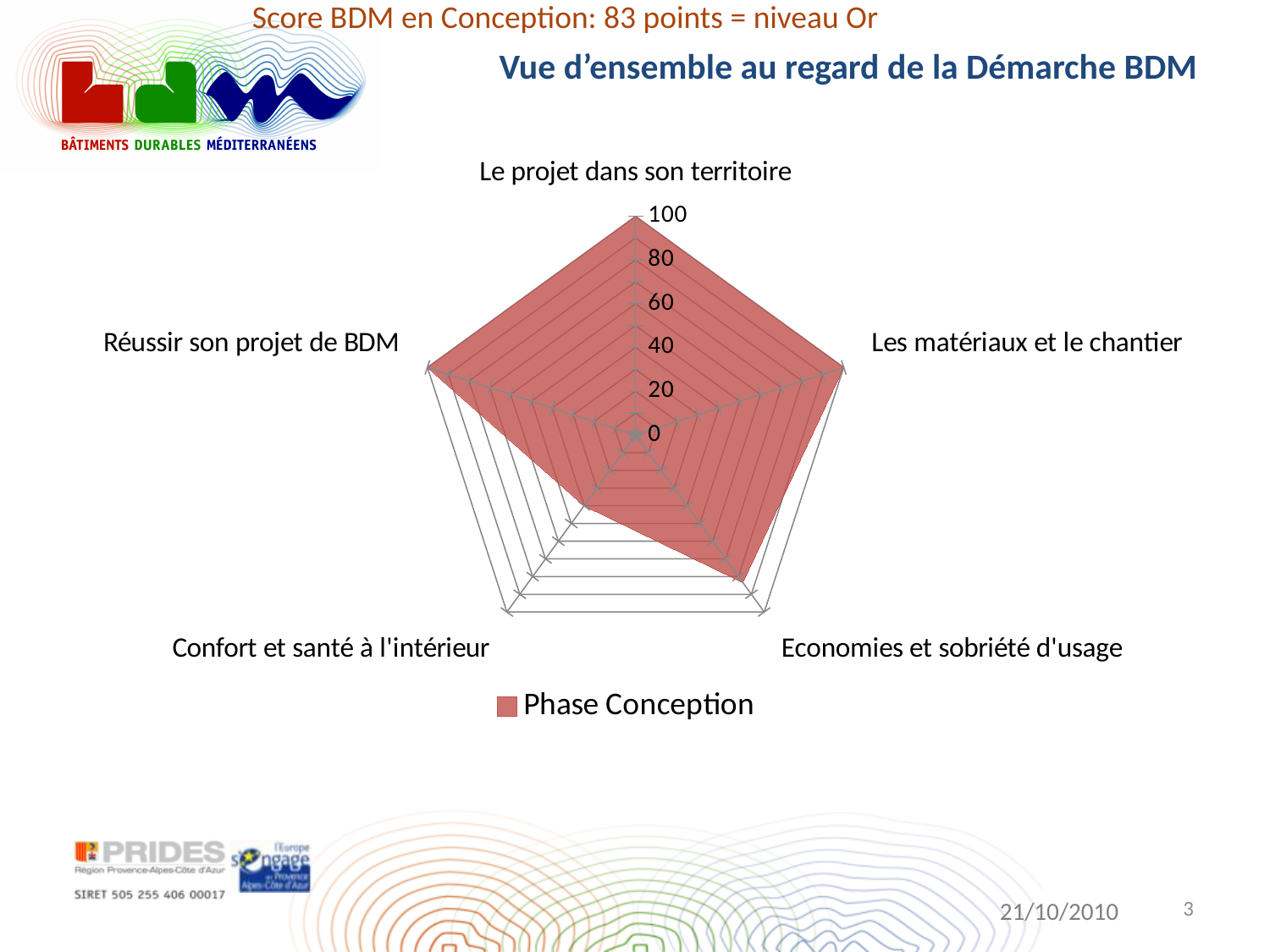
Is the value for Confort et santé à l'intérieur greater or less than 60? less Is the value for Confort et santé à l'intérieur greater or less than 20? greater What is the name of the series shown in the legend? Phase Conception How many series does the legend list? 1 How many categories (axes) does the radar chart have? 5 What kind of chart is shown on the slide? radar chart Is the value for Le projet dans son territoire greater or less than 80? greater What is the maximum value shown on the chart's axis scale? 100 Which category has the lowest value for Phase Conception? Confort et santé à l'intérieur Which is larger, the value for Economies et sobriété d'usage or the value for Confort et santé à l'intérieur? Economies et sobriété d'usage